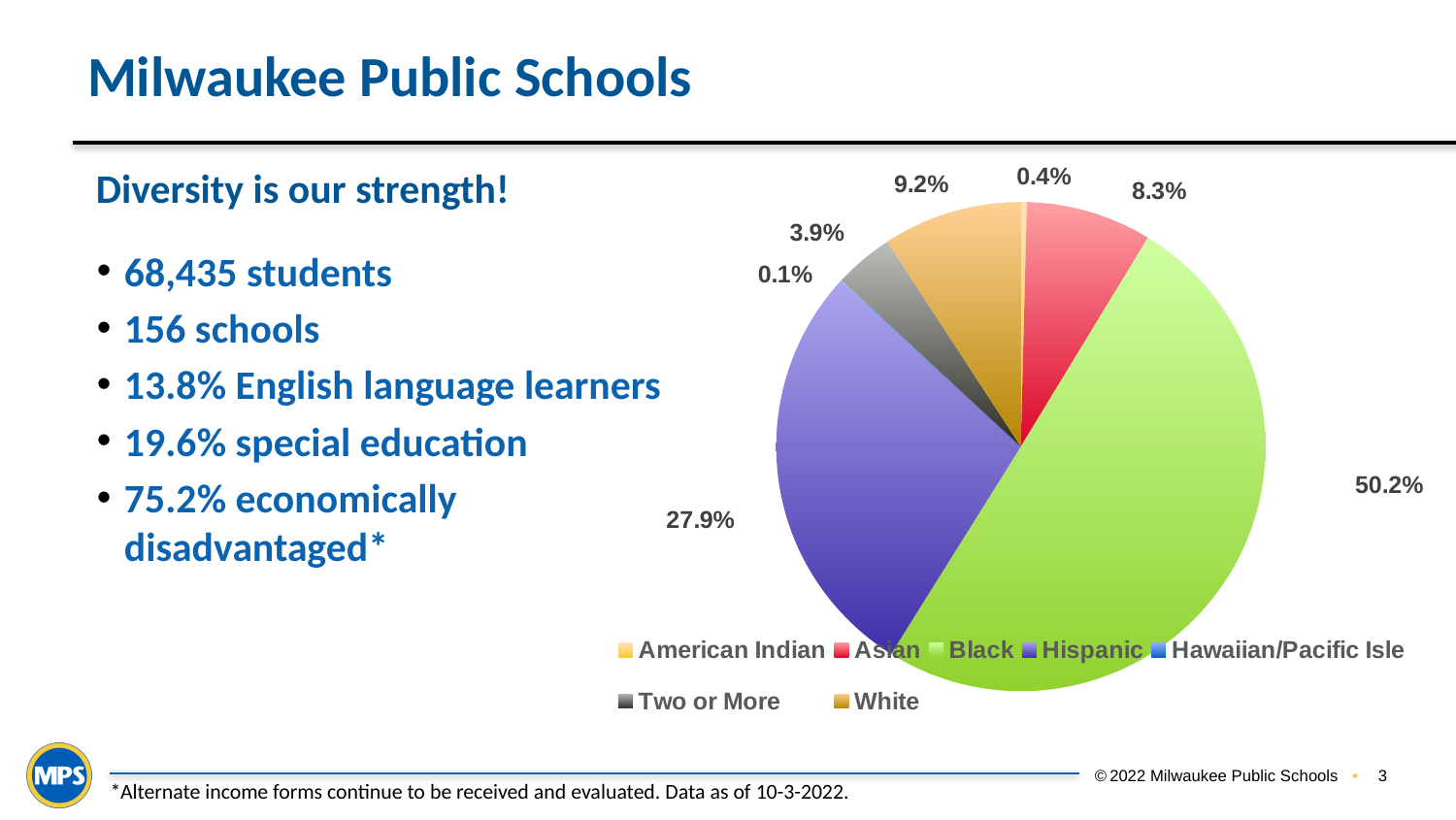
Which category has the largest share of the pie chart? Black What percentage of the pie chart is labelled for Black students? 50.2% Which category has the smallest share of the pie chart? Hawaiian/Pacific Isle What percentage of the pie chart is labelled for Two or More? 3.9% How many categories does the legend of the pie chart list? 7 What percentage of the pie chart is labelled for Hispanic students? 27.9% What percentage of the pie chart is labelled for White students? 9.2% What is the difference between the Black share and the Hispanic share in the pie chart? 22.3% What kind of chart is shown on the slide? pie chart Which share is larger in the pie chart, White or Asian? White Which colour represents Hispanic in the pie chart? purple What percentage of the pie chart is labelled for Asian students? 8.3%